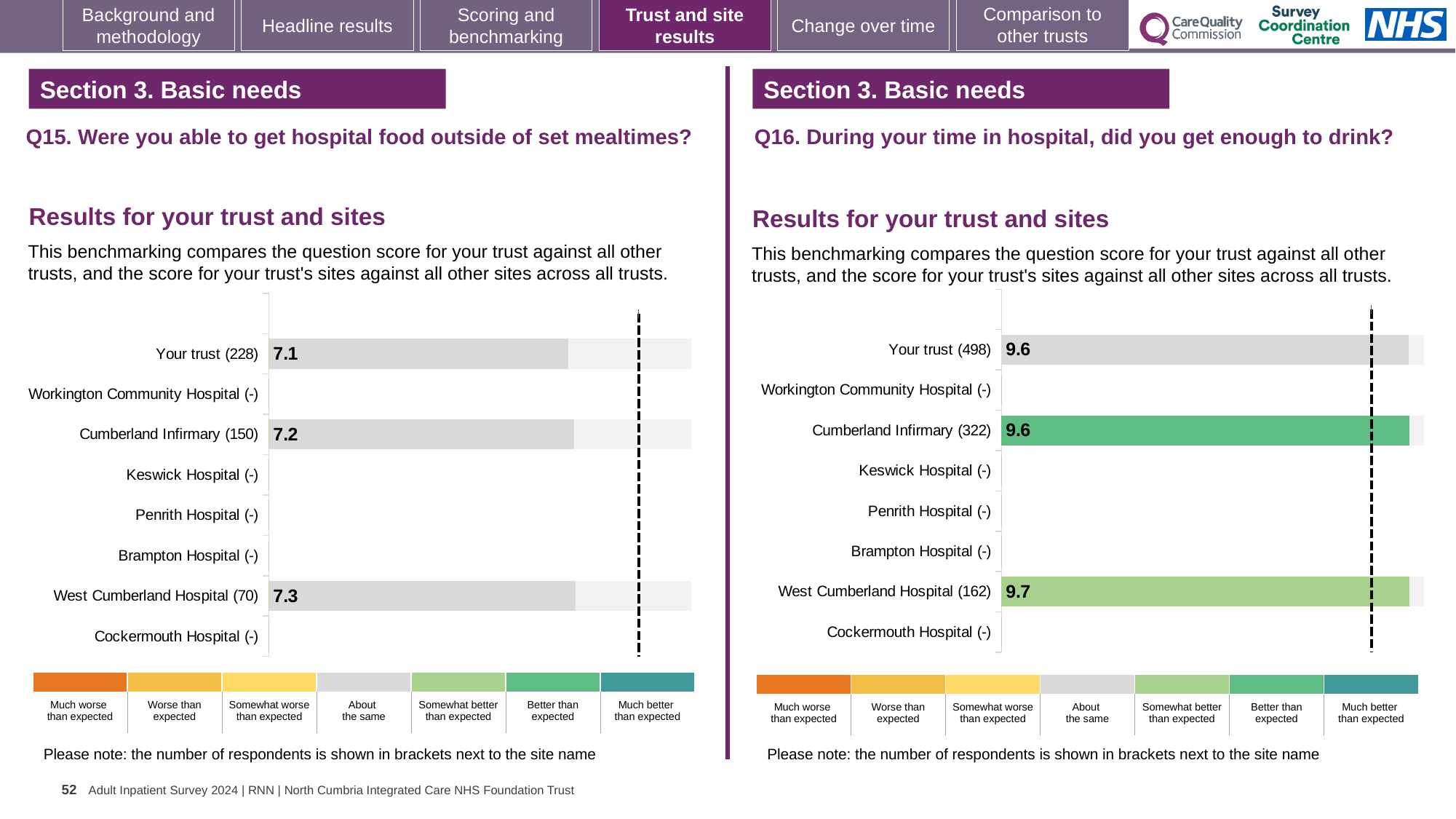
In the Q16 chart (right), which benchmark category does the colour of the Cumberland Infirmary (322) bar correspond to? Better than expected In the Q16 chart (right), what is the score for West Cumberland Hospital (162)? 9.7 In the Q15 chart (left), what is the score for West Cumberland Hospital (70)? 7.3 In the Q16 chart (right), what is the difference between the scores for West Cumberland Hospital (162) and Cumberland Infirmary (322)? 0.1 In the Q15 chart (left), what is the score for Cumberland Infirmary (150)? 7.2 In the Q15 chart (left), what is the score for Your trust (228)? 7.1 In the Q15 chart (left), which row has the lowest printed score? Your trust (228) What type of chart is used for the Q15 results (left)? Bar chart In the Q15 chart (left), which site or trust row has the highest printed score? West Cumberland Hospital (70) In the Q16 chart (right), what is the score for Your trust (498)? 9.6 In the Q15 chart (left), what is the difference between the scores for West Cumberland Hospital (70) and Your trust (228)? 0.2 How many site or trust rows are listed on the y axis of the Q16 chart (right)? 8